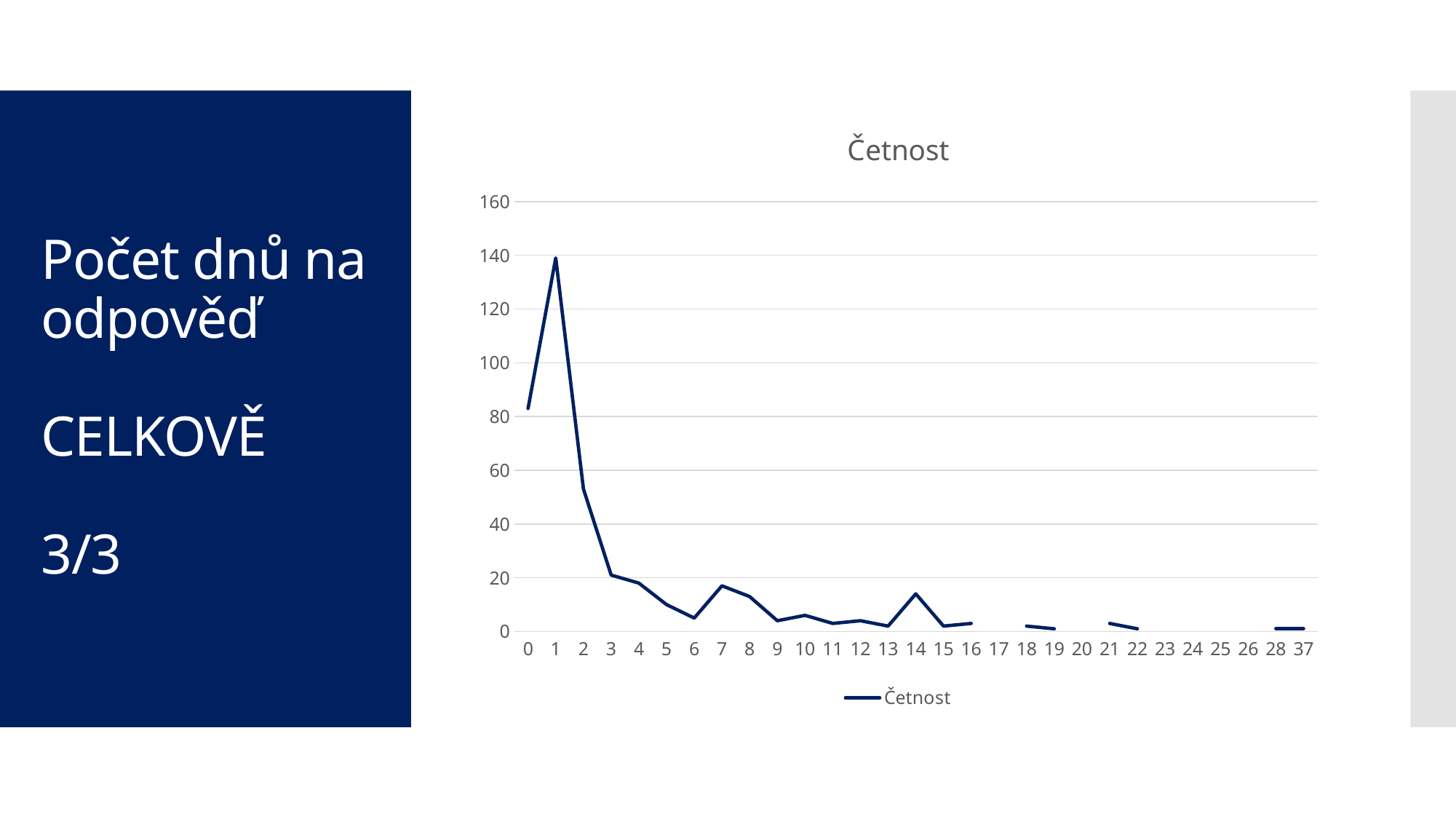
Is the value for category 1 greater or less than 120? greater What is the title of the chart? Četnost Is the value for category 3 greater or less than 40? less Is the value for category 2 greater or less than 60? less What kind of chart is shown on the slide? line chart How many categories are labelled on the x axis? 29 Do the values rise or fall from category 1 to category 6? fall Which has the larger value, category 2 or category 3? 2 Which has the larger value, category 0 or category 1? 1 Which x-axis category has the highest value? 1 How many series does the legend list? 1